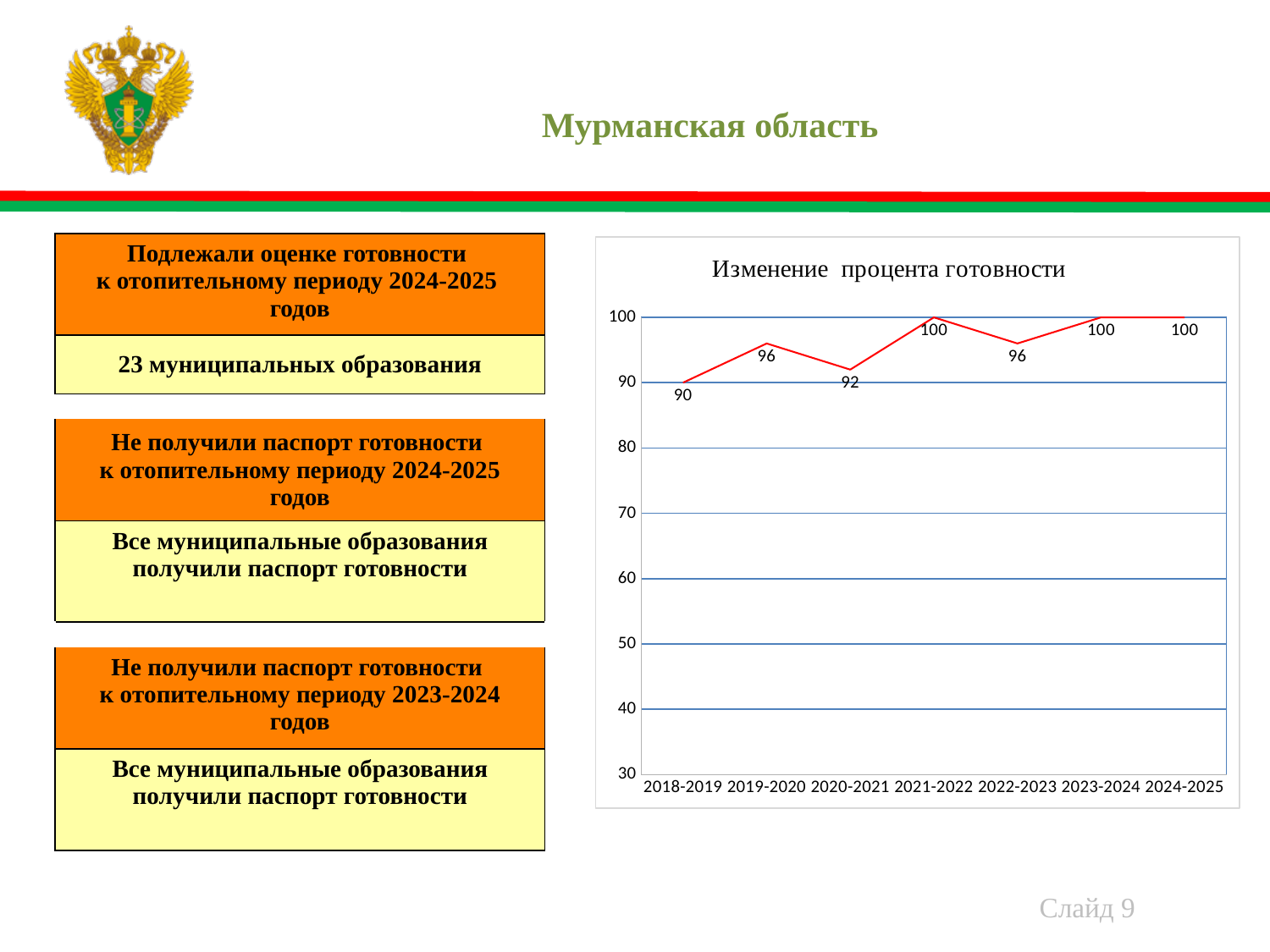
What is the difference between the values for 2019-2020 and 2018-2019? 6 What is the value for 2020-2021 in the chart? 92 How many periods are shown on the x axis of the chart? 7 What is the title of the chart on the slide? Изменение процента готовности What is the value for 2024-2025 in the chart? 100 What kind of chart is shown on the slide? line chart What is the value for 2018-2019 in the chart 'Изменение процента готовности'? 90 Which period has the lowest value in the chart? 2018-2019 Do the values generally rise or fall from 2018-2019 to 2024-2025? rise What is the value for 2022-2023 in the chart? 96 Which is larger, the value for 2019-2020 or the value for 2020-2021? 2019-2020 What is the difference between the values for 2021-2022 and 2020-2021? 8